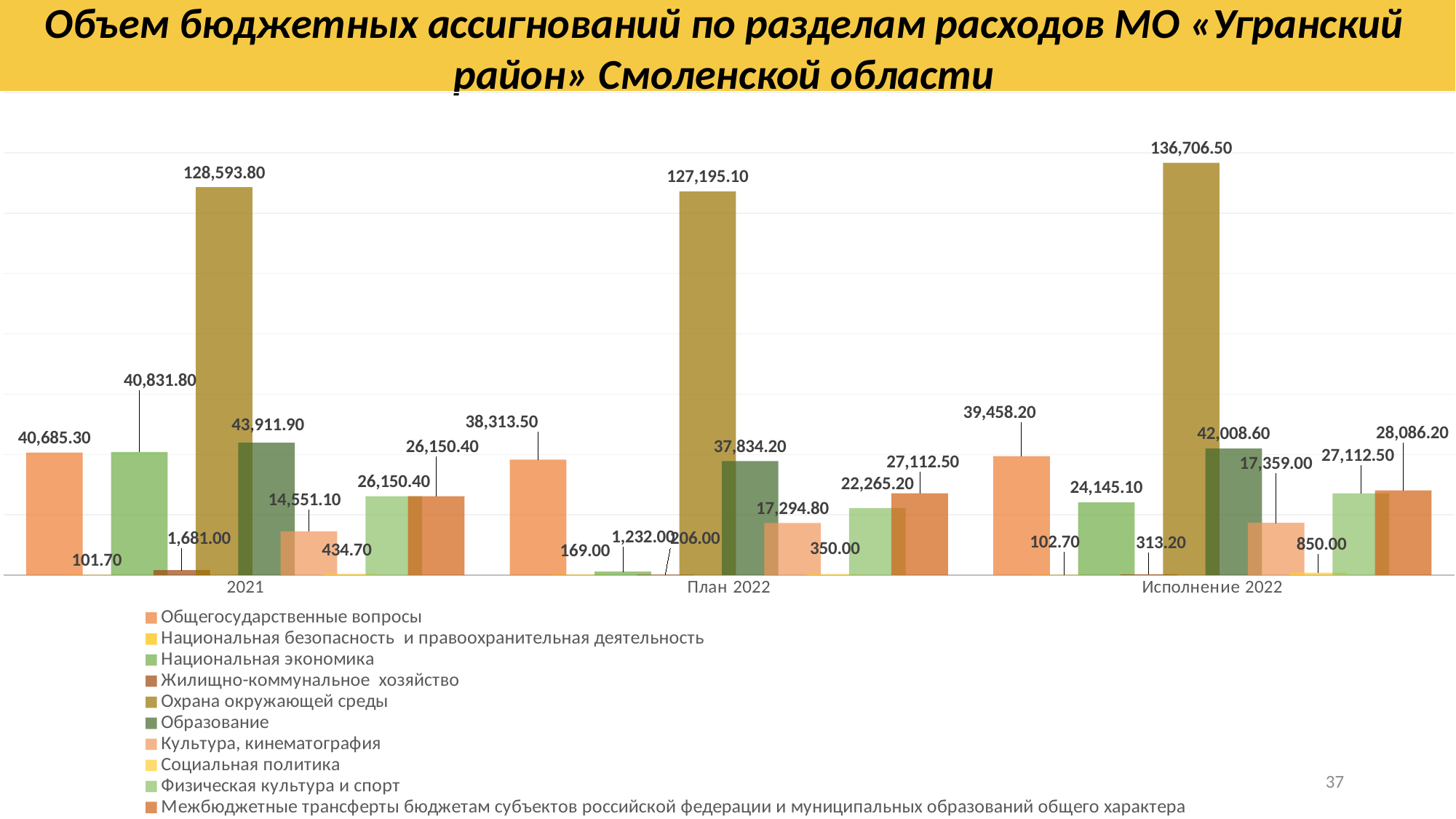
What is the value for Образование in Исполнение 2022? 42,008.60 Which x-axis category contains the tallest bar on the chart? Исполнение 2022 What is the value for Национальная экономика in 2021? 40,831.80 What is the difference between the Образование value in 2021 and in План 2022? 6,077.70 Which is larger for Общегосударственные вопросы: the value in 2021 or in План 2022? 2021 What is the highest value labeled in the Исполнение 2022 group? 136,706.50 How many categories are shown on the x axis of the chart? 3 What kind of chart is shown on the slide? Bar chart Does the value for Общегосударственные вопросы rise or fall from 2021 to План 2022? Falls What is the title of the chart on the slide? Объем бюджетных ассигнований по разделам расходов МО «Угранский район» Смоленской области How many series does the legend list? 10 What is the value for Общегосударственные вопросы in 2021? 40,685.30